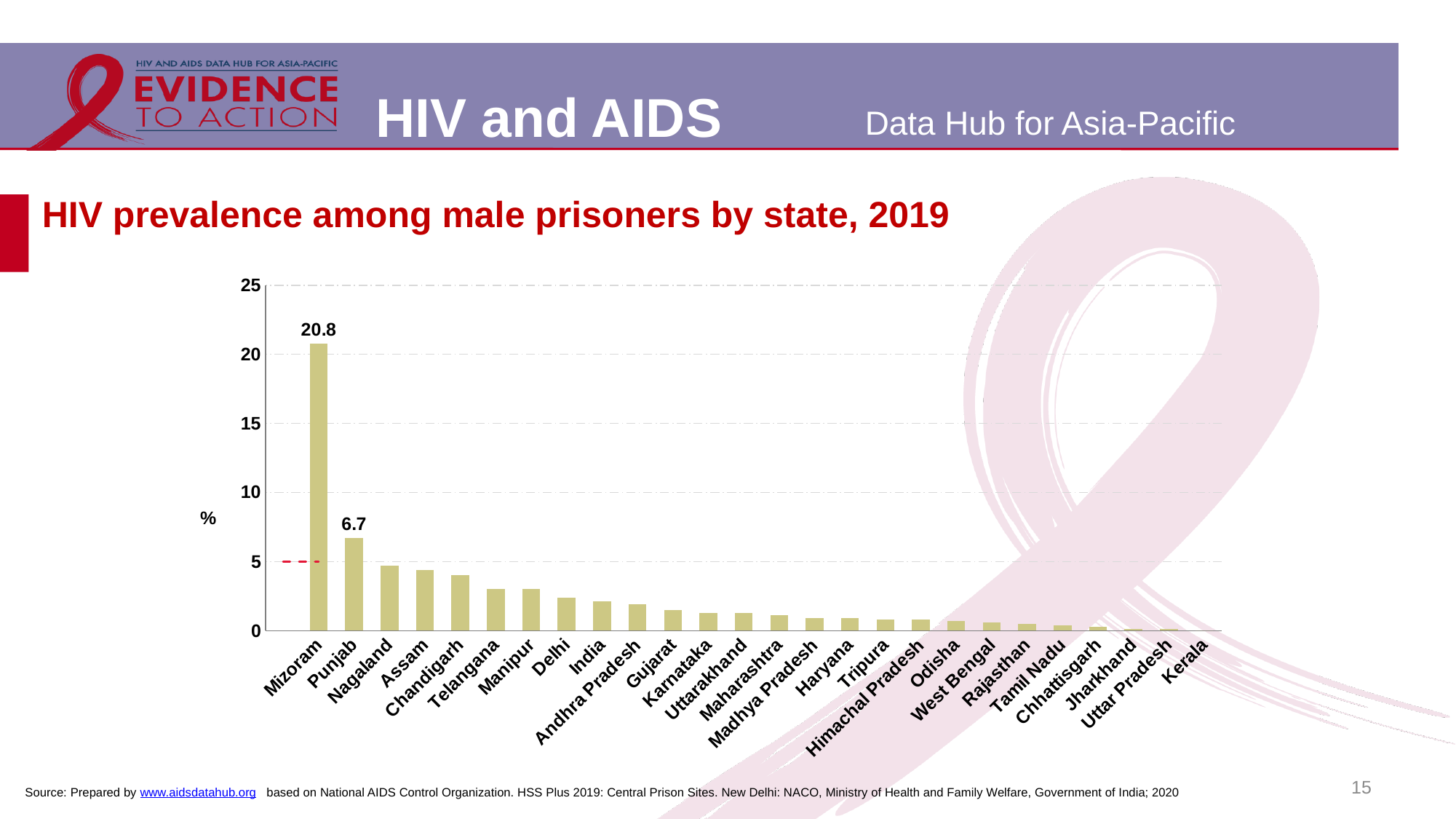
Do the values rise or fall moving from left to right along the x axis? Fall Which has a higher HIV prevalence among male prisoners, Nagaland or Delhi? Nagaland Is the value for Mizoram greater or less than 20? greater What is the HIV prevalence among male prisoners in Mizoram? 20.8 What is the difference between the HIV prevalence values for Mizoram and Punjab? 14.1 What kind of chart is used to show HIV prevalence among male prisoners by state? Bar chart Is the value for Delhi greater or less than 5? less Is the value for Chandigarh greater or less than 5? less Which has a higher HIV prevalence among male prisoners, Telangana or Kerala? Telangana What is the HIV prevalence among male prisoners in Punjab? 6.7 How many states/categories are shown on the x axis of the chart? 26 Which state has the highest HIV prevalence among male prisoners? Mizoram